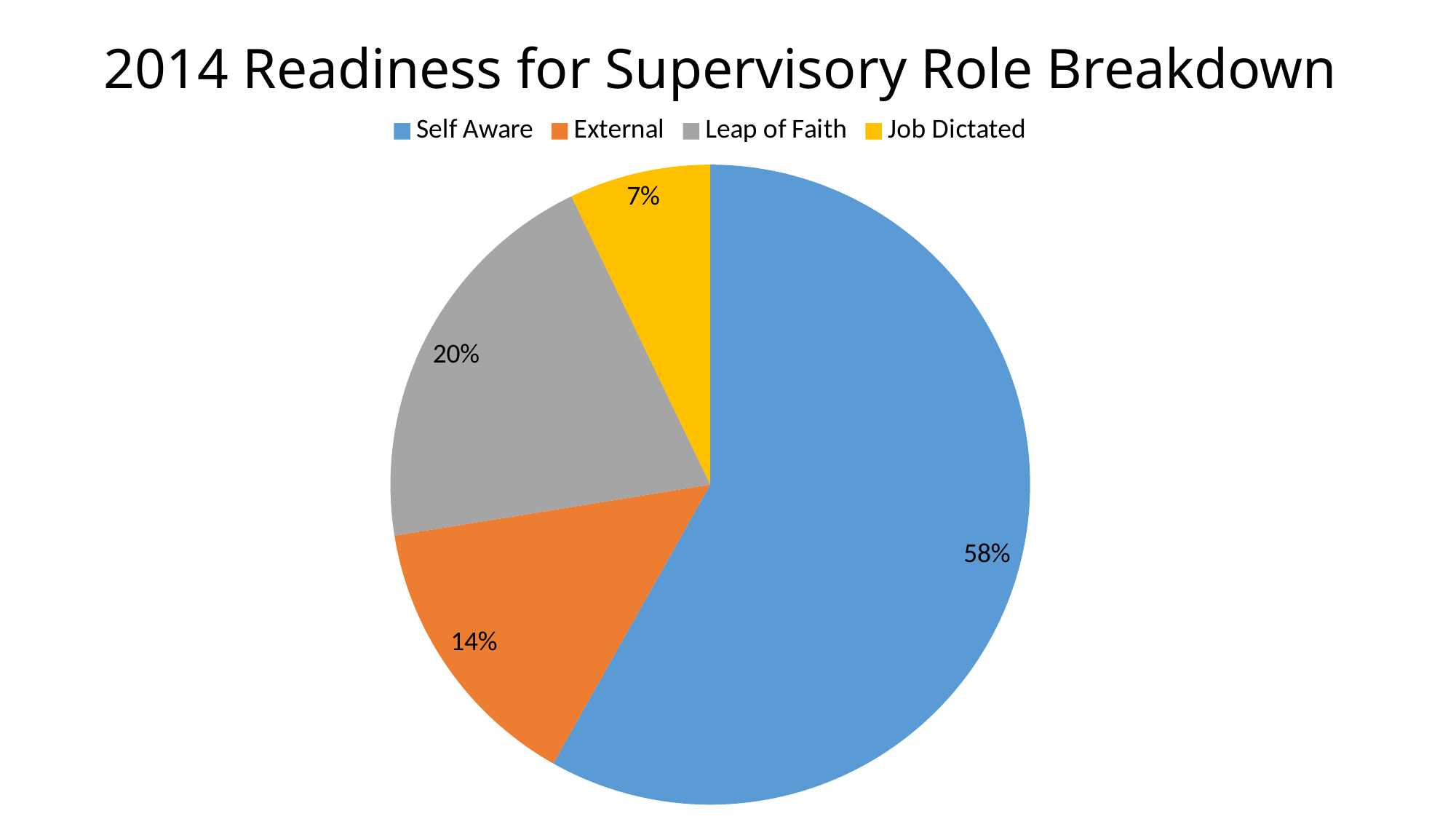
Which category has the largest share of the pie? Self Aware What colour is the Job Dictated slice? Yellow What type of chart is shown on the slide? Pie chart What percentage of the pie is Self Aware? 58% What is the difference in percentage points between Self Aware and Leap of Faith? 38 What percentage of the pie is Leap of Faith? 20% Which is larger, the share for External or the share for Leap of Faith? Leap of Faith Which category has the smallest share of the pie? Job Dictated How many categories does the legend list? 4 What is the title of the chart? 2014 Readiness for Supervisory Role Breakdown What percentage of the pie is Job Dictated? 7% What percentage of the pie is External? 14%